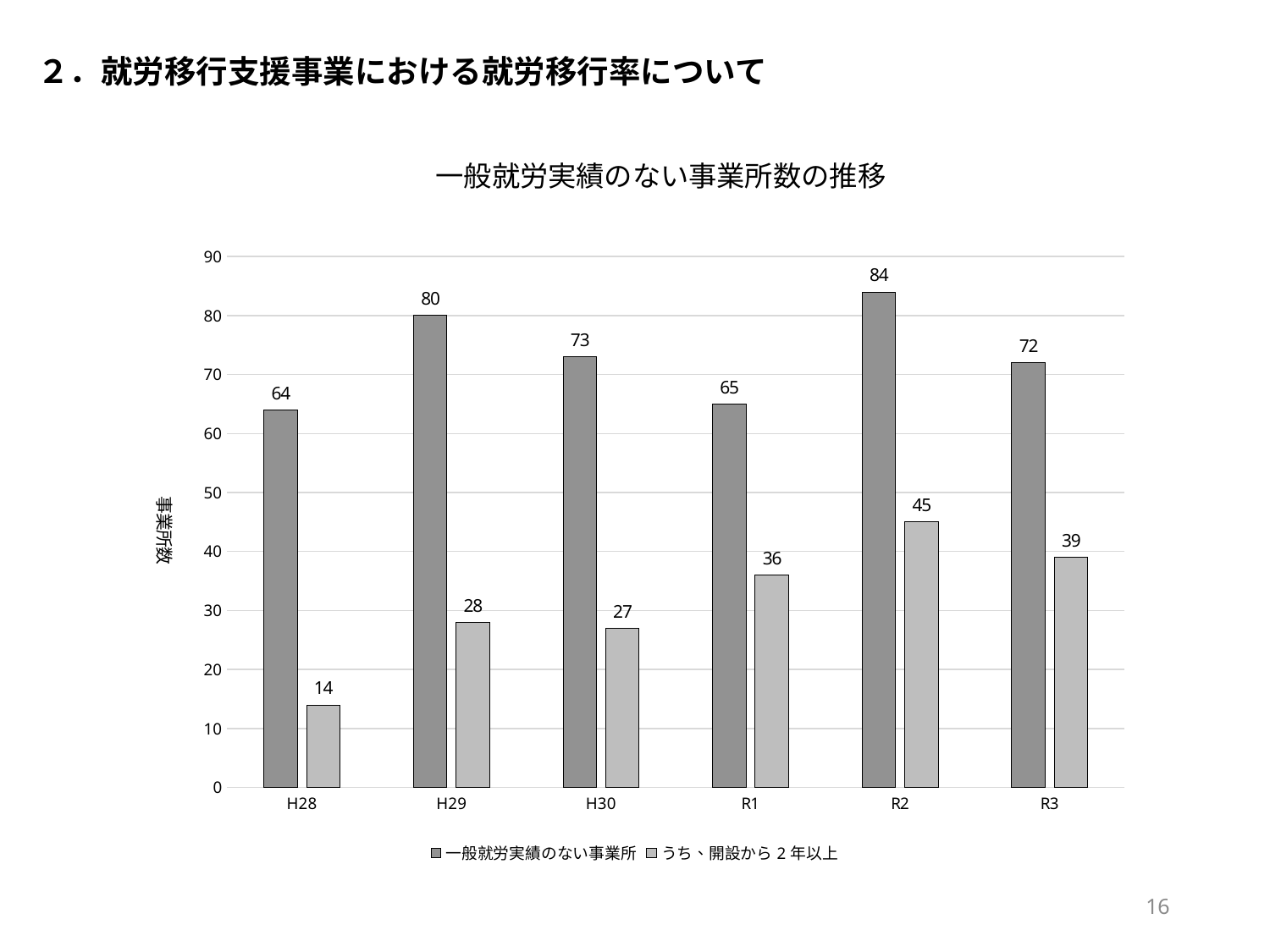
What is the value for うち、開設から２年以上 in H28? 14 Which is larger: 一般就労実績のない事業所 in H30 or in R1? H30 Does the value for うち、開設から２年以上 rise or fall from H28 to R1? Rise What is the value for 一般就労実績のない事業所 in H29? 80 How many years are shown on the x axis? 6 Which year has the highest value for 一般就労実績のない事業所? R2 Which year has the lowest value for うち、開設から２年以上? H28 What is the difference between 一般就労実績のない事業所 and うち、開設から２年以上 in R3? 33 How many series does the legend list? 2 What kind of chart is shown on the slide? Bar chart What is the value for うち、開設から２年以上 in R2? 45 What is the title of the chart? 一般就労実績のない事業所数の推移